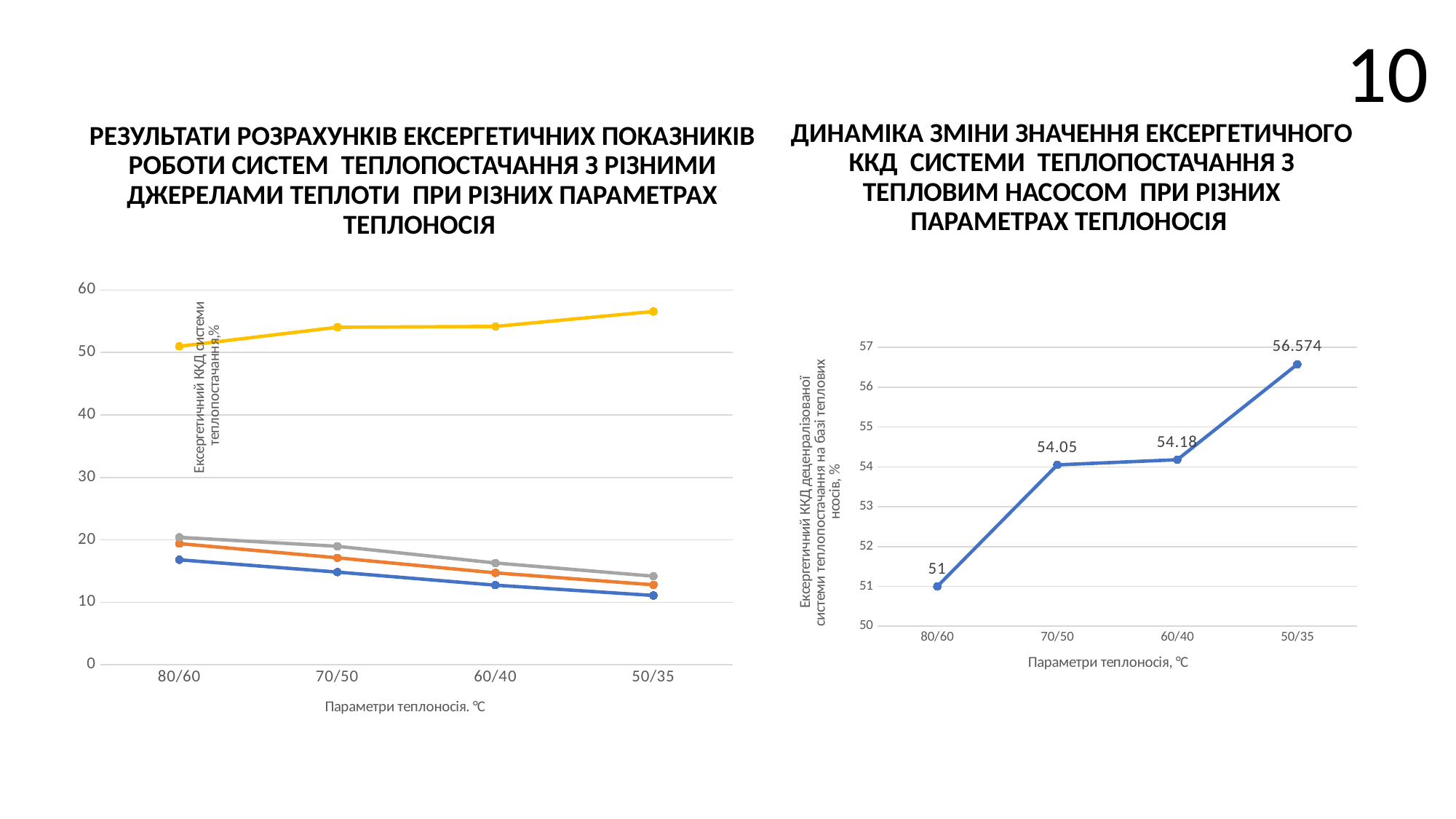
On the right chart, what is the difference between the values for 50/35 and 80/60? 5.574 On the right chart, what is the difference between the values for 60/40 and 70/50? 0.13 On the right chart, what is the value for 80/60? 51 On the left chart, is the value of the yellow line at 50/35 greater or less than 50? greater On the right chart, which parameter has the lowest value? 80/60 On the right chart, what is the value for 50/35? 56.574 On the right chart, which parameter has the highest value? 50/35 On the left chart, how many categories are shown on the x axis? 4 On the right chart, do the values rise or fall from 80/60 to 50/35? rise On the right chart, how many data points are plotted? 4 On the right chart, what is the value for 70/50? 54.05 What kind of chart is the left chart? line chart